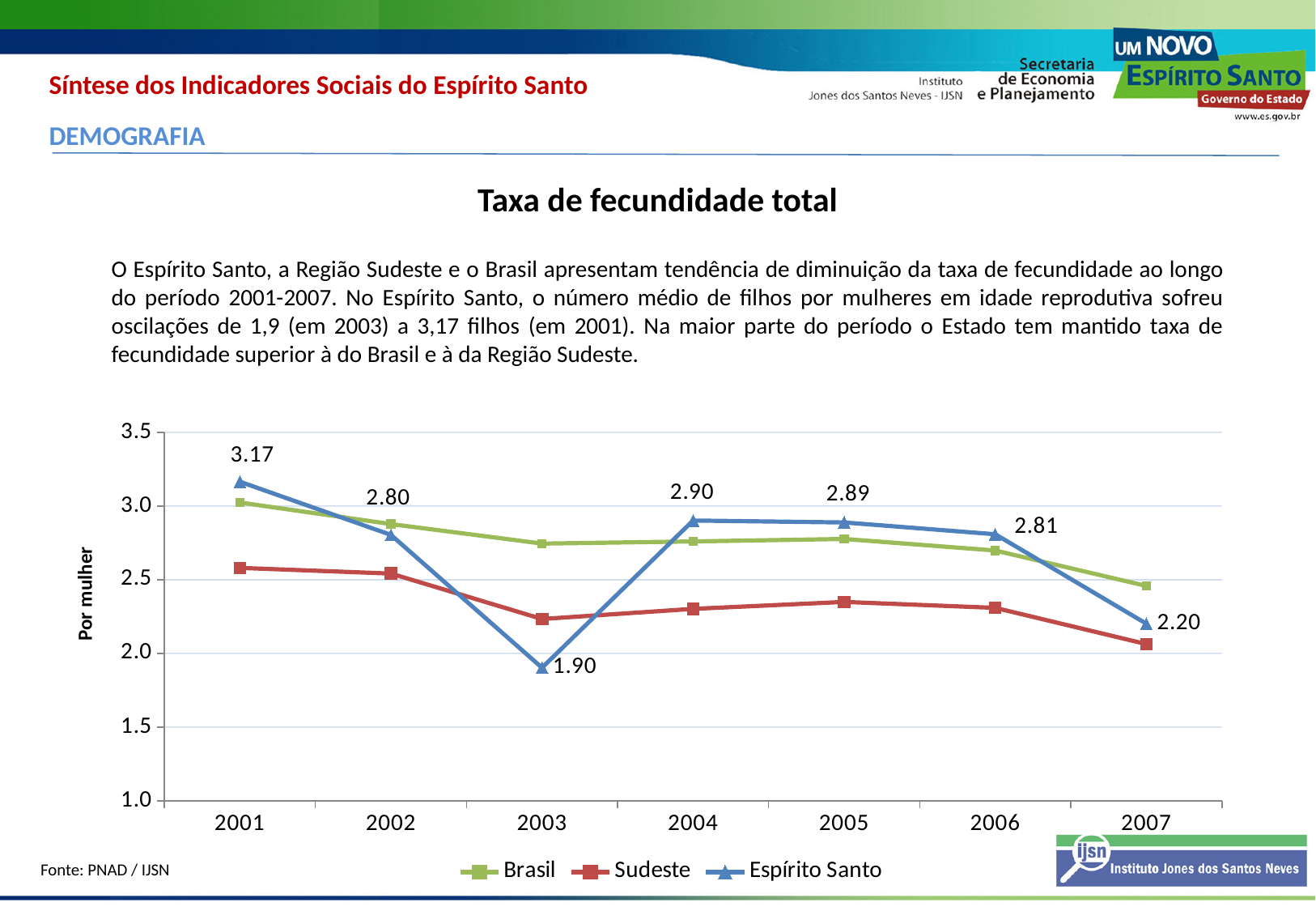
How many years are shown on the x axis? 7 What is the value for Espírito Santo in 2003? 1.90 What kind of chart is shown on the slide? line chart In which year is the Espírito Santo series at its highest? 2001 How many series does the legend list? 3 What is the value for Espírito Santo in 2007? 2.20 What is the difference between the Espírito Santo values for 2001 and 2007? 0.97 In which year is the Espírito Santo series at its lowest? 2003 Is the value for Brasil in 2007 greater or less than 2.5? less Is the value for Sudeste in 2003 greater or less than 2.5? less What is the value for Espírito Santo in 2001? 3.17 Which is larger for Espírito Santo: the value in 2001 or the value in 2004? 2001